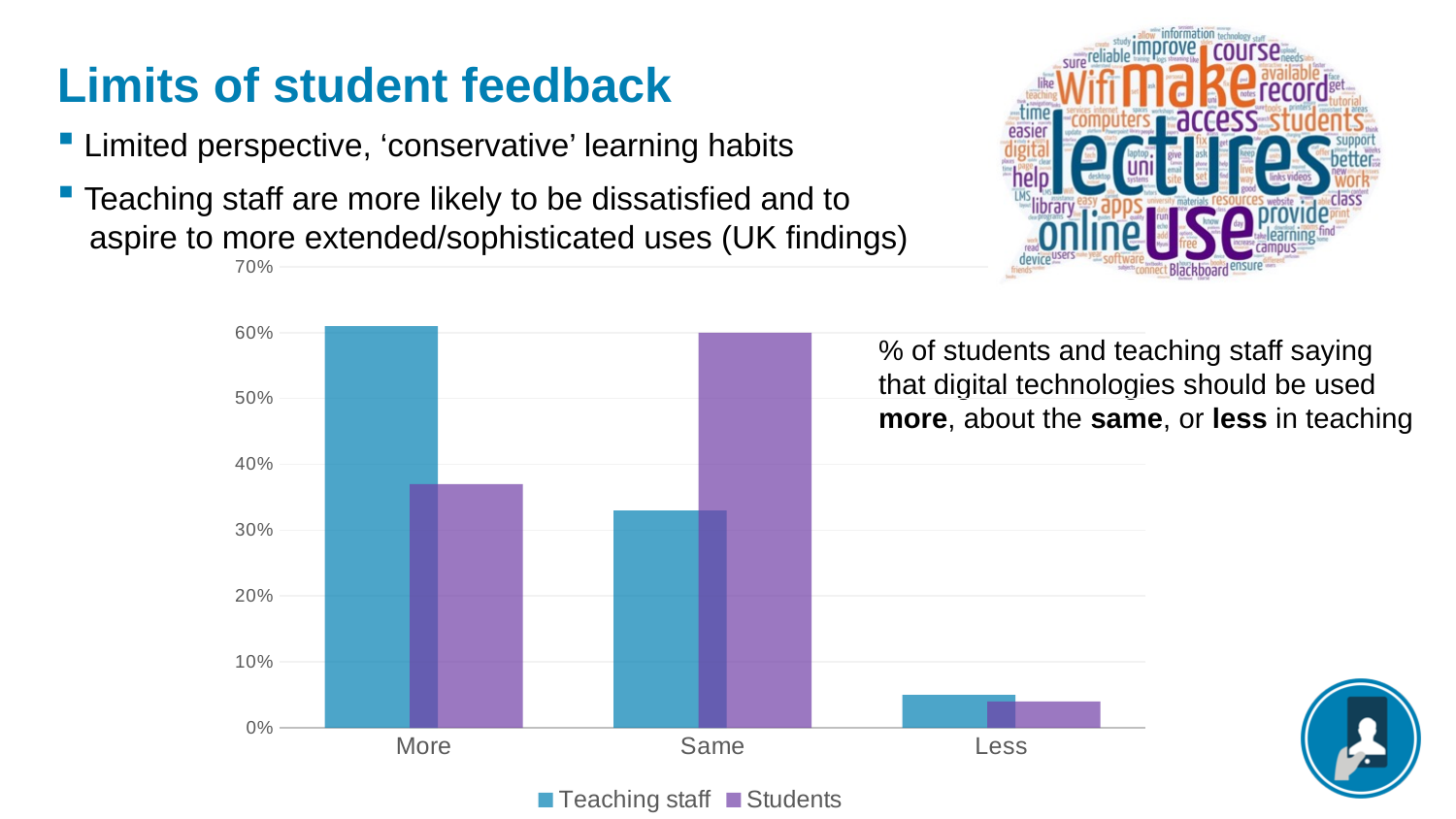
Is the Students value for More greater or less than 40%? less What kind of chart is shown on the slide? bar chart Is the Teaching staff value for Less greater or less than 10%? less For the Students series, which category has the highest value? Same Is the Teaching staff value for More greater or less than 50%? greater What are the two series named in the chart legend? Teaching staff and Students For the Teaching staff series, which category has the highest value? More How many series does the chart legend list? 2 In the More category, which series has the larger value, Teaching staff or Students? Teaching staff For the Teaching staff series, which category has the lowest value? Less In the Same category, which series has the larger value, Teaching staff or Students? Students How many categories are shown on the x axis of the chart? 3